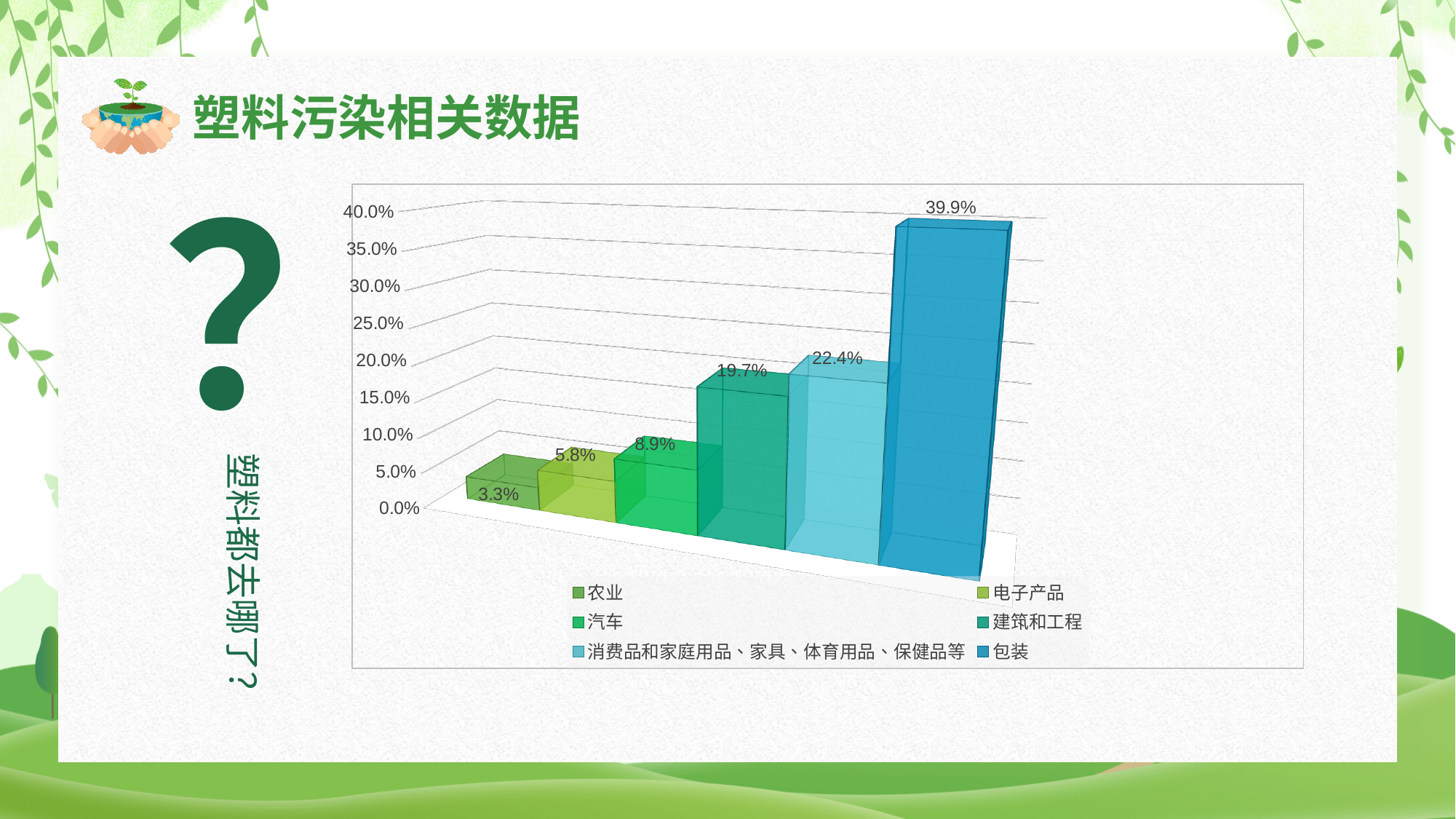
Which is larger, the value for 汽车 or the value for 电子产品? 汽车 What is the value for 包装? 39.9% How many entries does the legend list? 6 Which category has the highest value? 包装 What is the value for 电子产品? 5.8% What is the value for 农业? 3.3% What kind of chart is shown on the slide? bar chart Which category has the lowest value? 农业 What is the value for 建筑和工程? 19.7% How many bars are plotted in the chart? 6 What is the difference between the values for 包装 and 建筑和工程? 20.2% Is the value for 消费品和家庭用品、家具、体育用品、保健品等 greater or less than 20.0%? greater